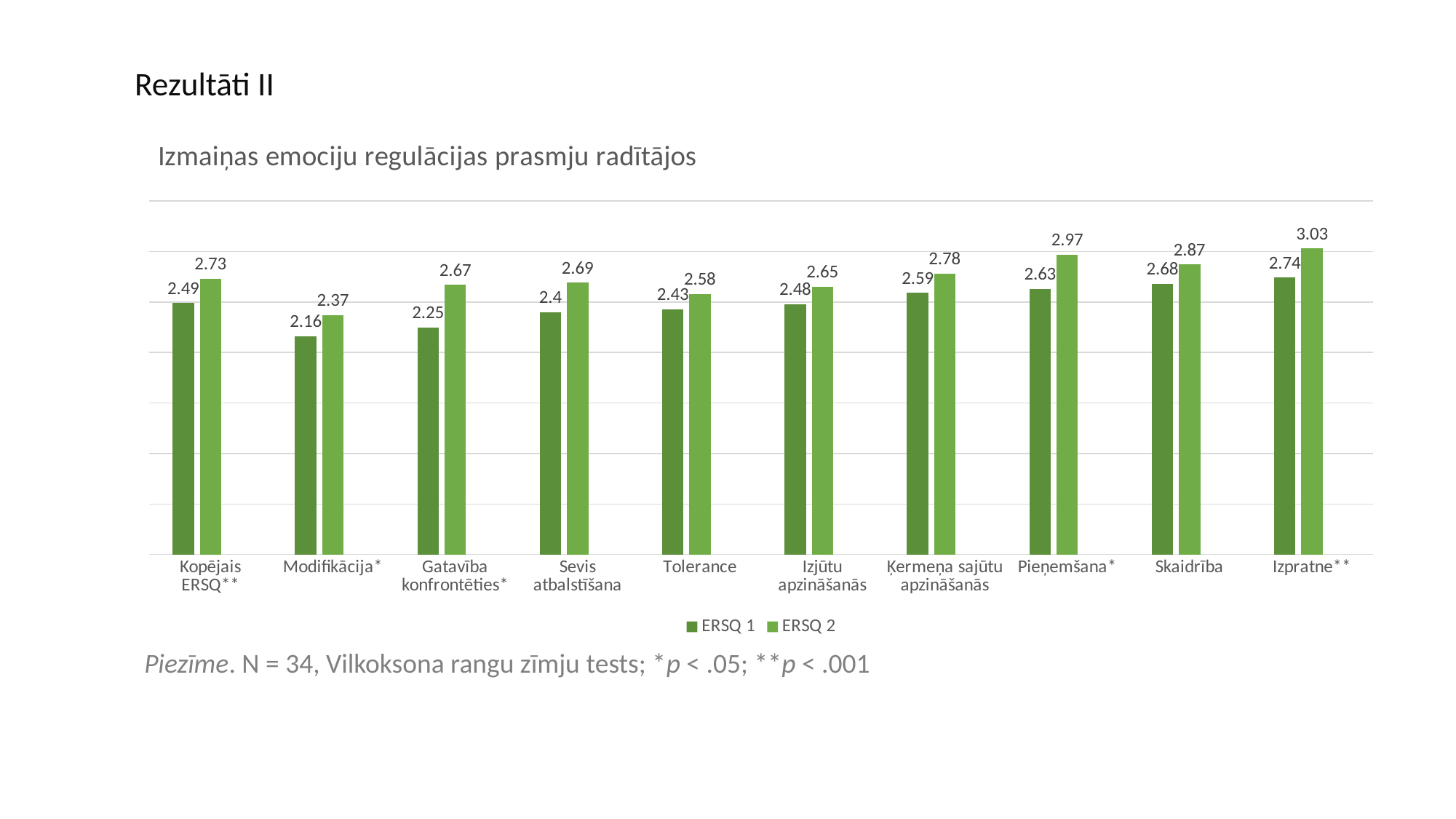
What is the ERSQ 2 value for Izpratne**? 3.03 How many series does the legend list? 2 What is the difference between the ERSQ 2 and ERSQ 1 values for Gatavība konfrontēties*? 0.42 What is the title of the chart? Izmaiņas emociju regulācijas prasmju radītājos Which is larger: the ERSQ 1 value for Pieņemšana* or the ERSQ 1 value for Skaidrība? Skaidrība What kind of chart is shown on the slide? Bar chart What is the ERSQ 2 value for Tolerance? 2.58 Which category has the lowest ERSQ 1 value? Modifikācija* What are the two series named in the legend? ERSQ 1 and ERSQ 2 How many categories are shown on the x axis? 10 Which category has the highest ERSQ 2 value? Izpratne** What is the ERSQ 1 value for Modifikācija*? 2.16